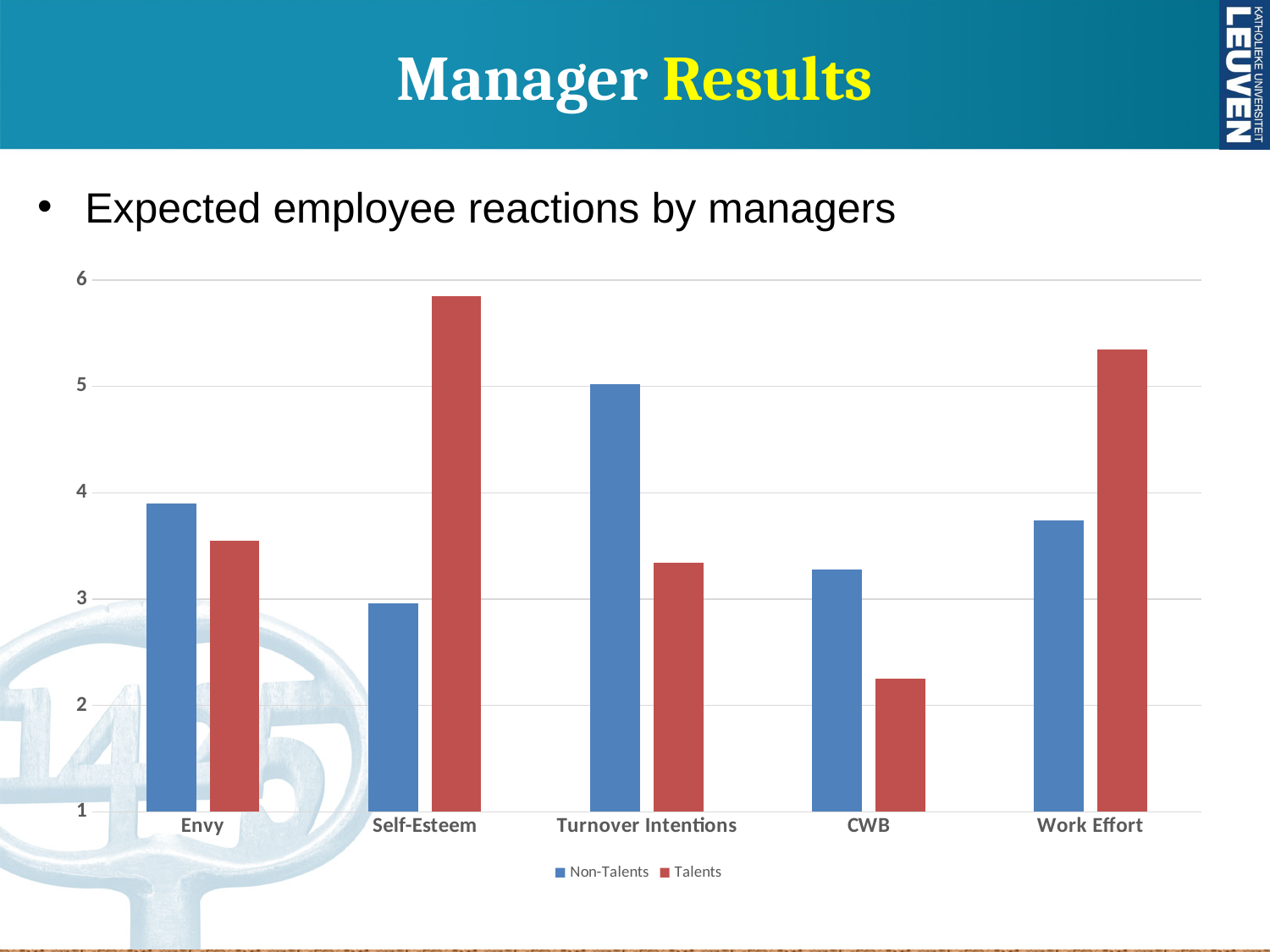
For which category is the Non-Talents bar the highest? Turnover Intentions Which two series are listed in the chart's legend? Non-Talents and Talents How many categories are shown on the x axis of the chart? 5 Is the value for Talents in Self-Esteem greater or less than 5? greater For which category is the Talents bar the lowest? CWB Is the value for Talents in CWB greater or less than 3? less For which category is the Talents bar the highest? Self-Esteem For Envy, which series has the larger value, Non-Talents or Talents? Non-Talents How many series does the chart's legend list? 2 For which category is the Non-Talents bar the lowest? Self-Esteem What kind of chart is shown on the slide? bar chart For Work Effort, which series has the larger value, Non-Talents or Talents? Talents